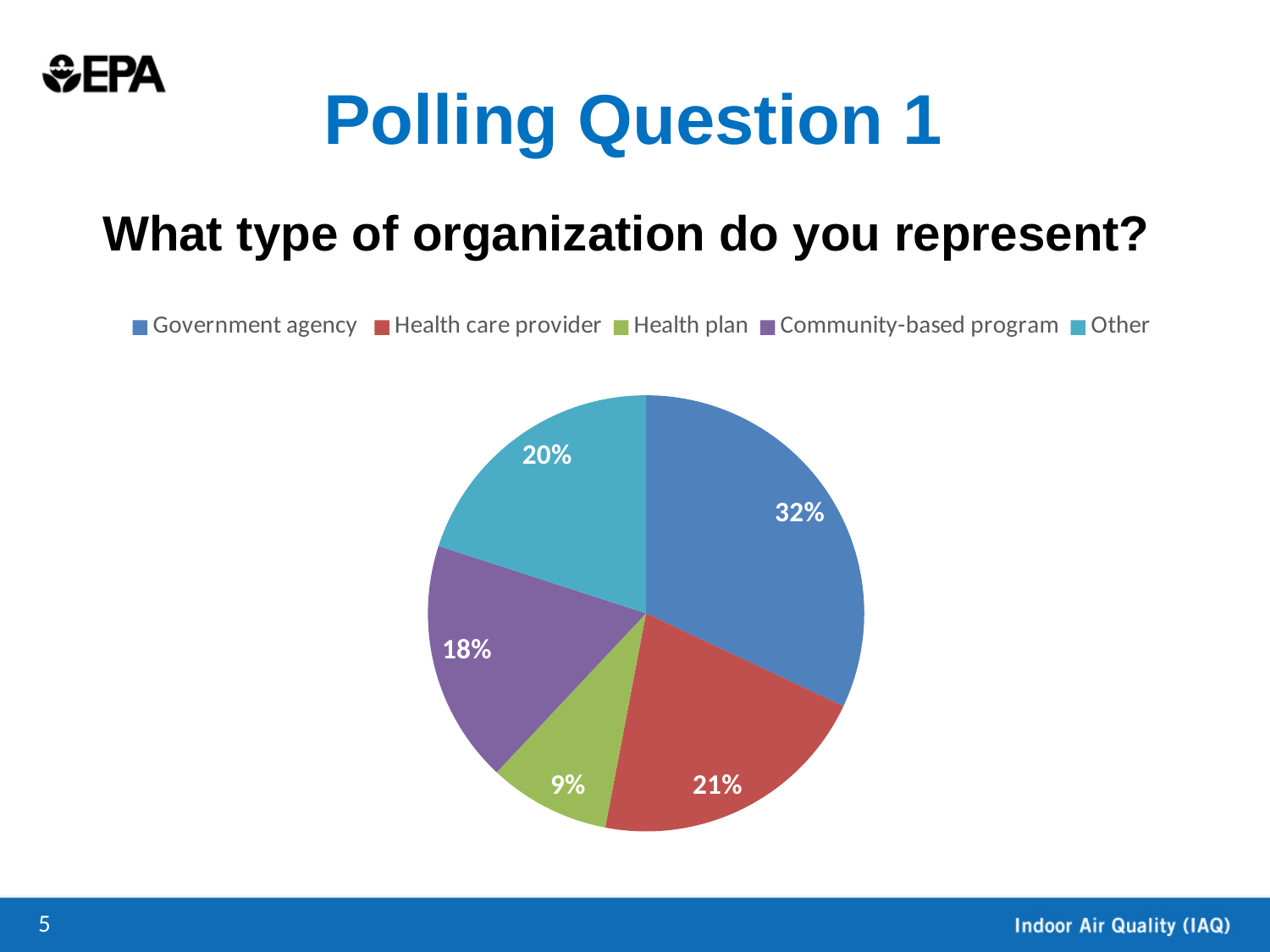
Which category has the largest slice of the pie? Government agency What colour is the slice for Health plan? Green What share of the pie does Other represent? 20% What kind of chart is shown on the slide? Pie chart What is the difference in percentage points between Government agency and Health care provider? 11 Which is larger, the share for Other or the share for Community-based program? Other What share of the pie does Health care provider represent? 21% What share of the pie does Community-based program represent? 18% Which category has the smallest slice of the pie? Health plan How many categories are shown in the pie chart? 5